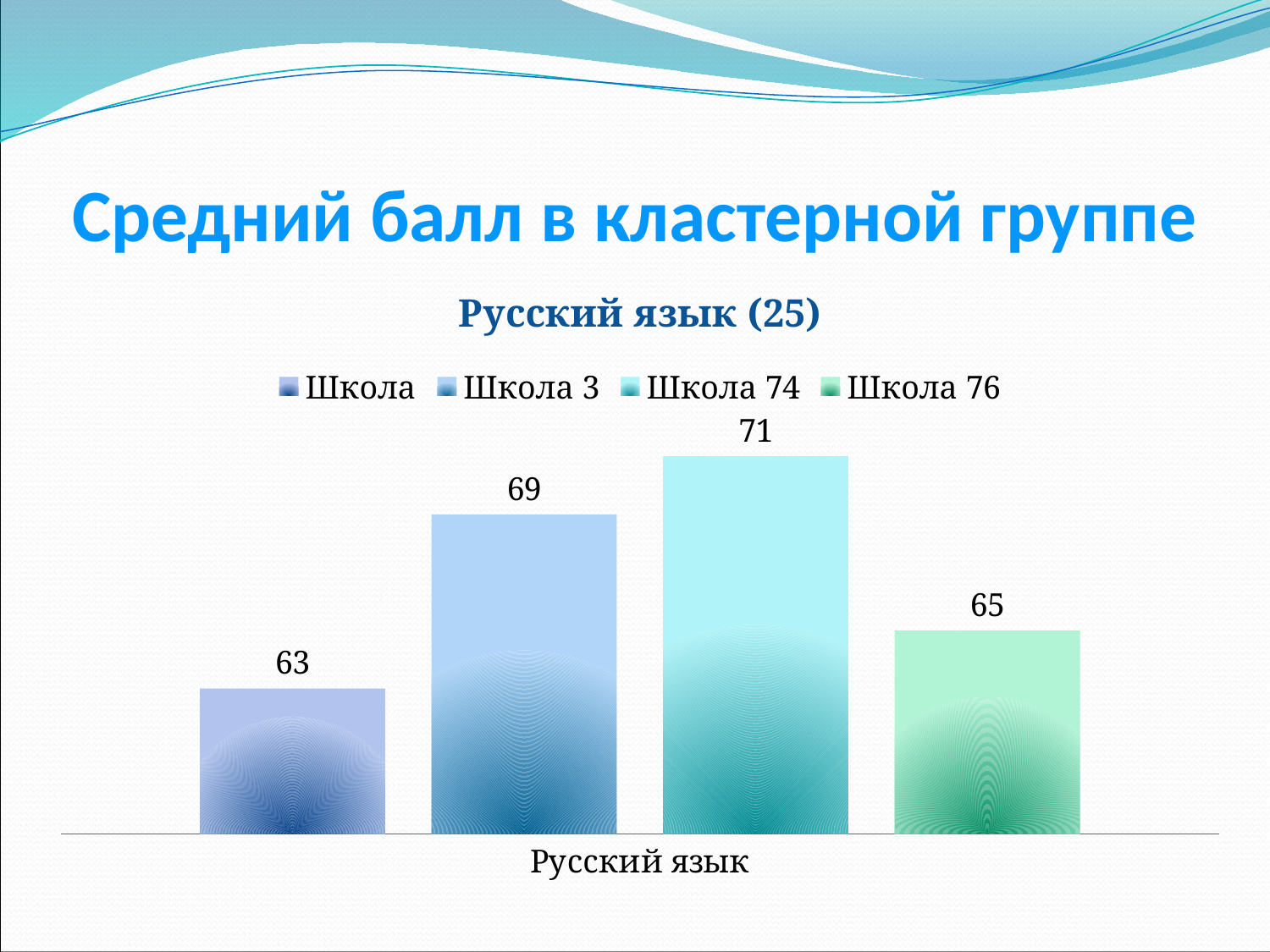
How many series does the legend list? 4 Which series has the highest value? Школа 74 Which series has the lowest value? Школа What is the title of the chart? Русский язык (25) What is the value for Школа 76? 65 What is the difference between the values for Школа 74 and Школа 3? 2 What kind of chart is shown on the slide? Bar chart What is the value for Школа 74? 71 What is the value for Школа 3? 69 What is the value for the series labelled Школа? 63 Which is larger, the value for Школа 3 or the value for Школа 76? Школа 3 What is the difference between the values for Школа 76 and Школа? 2